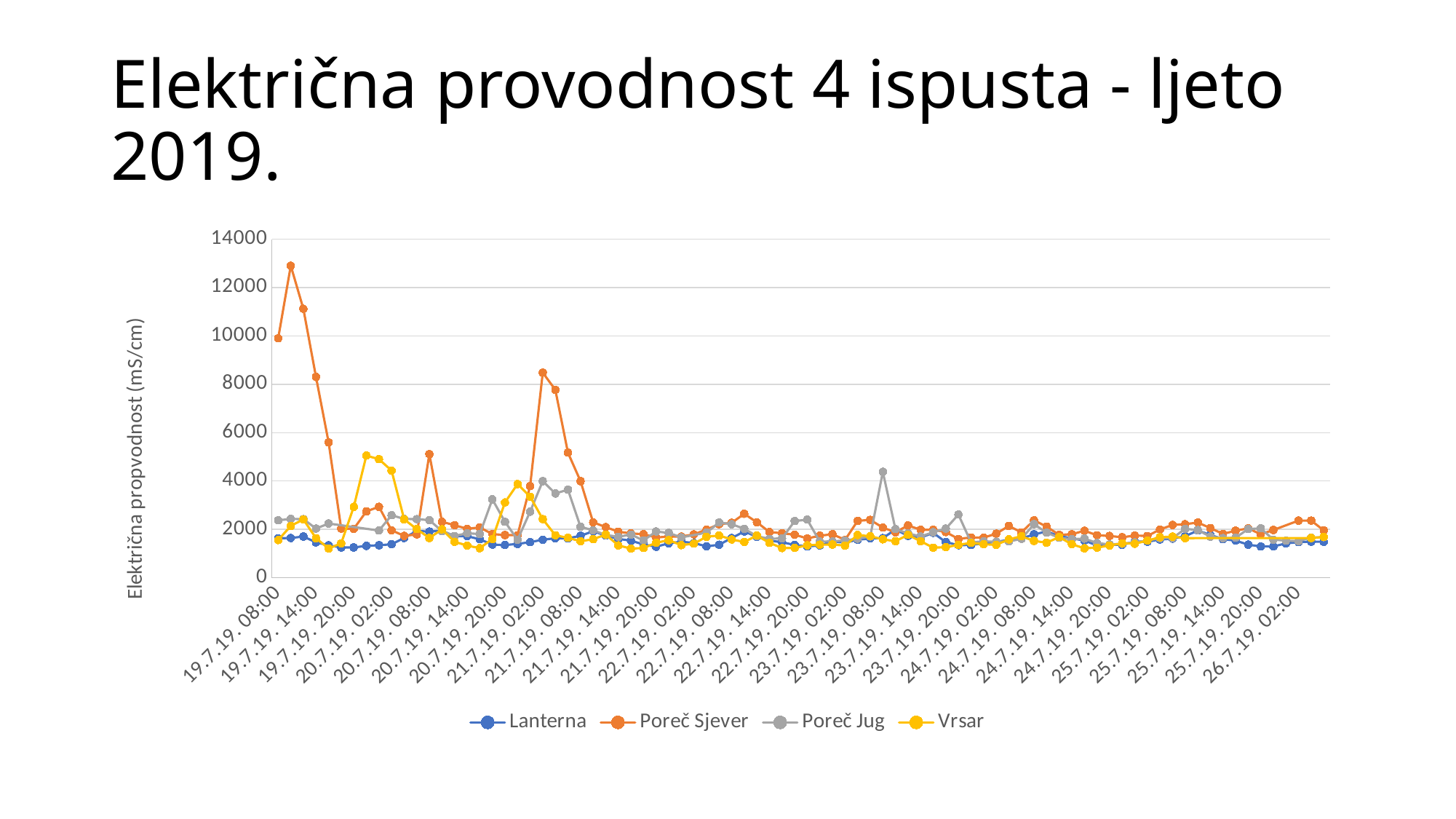
What kind of chart is shown on the slide? Line chart Which series reaches the highest value on the chart? Poreč Sjever What is the label of the vertical axis? Električna propvodnost (mS/cm) Is the highest value for Poreč Sjever greater or less than 12000? greater At 19.7.19 08:00, which is larger: the value for Poreč Sjever or the value for Lanterna? Poreč Sjever Is the highest value for Vrsar greater or less than 4000? greater Is the value for Lanterna at 19.7.19 08:00 greater or less than 2000? less How many series does the legend list? 4 Does the value for Poreč Sjever rise or fall between 19.7.19 14:00 and 19.7.19 20:00? fall What is the title of the chart on the slide? Električna provodnost 4 ispusta - ljeto 2019. Which series has the highest value at 23.7.19 08:00? Poreč Jug